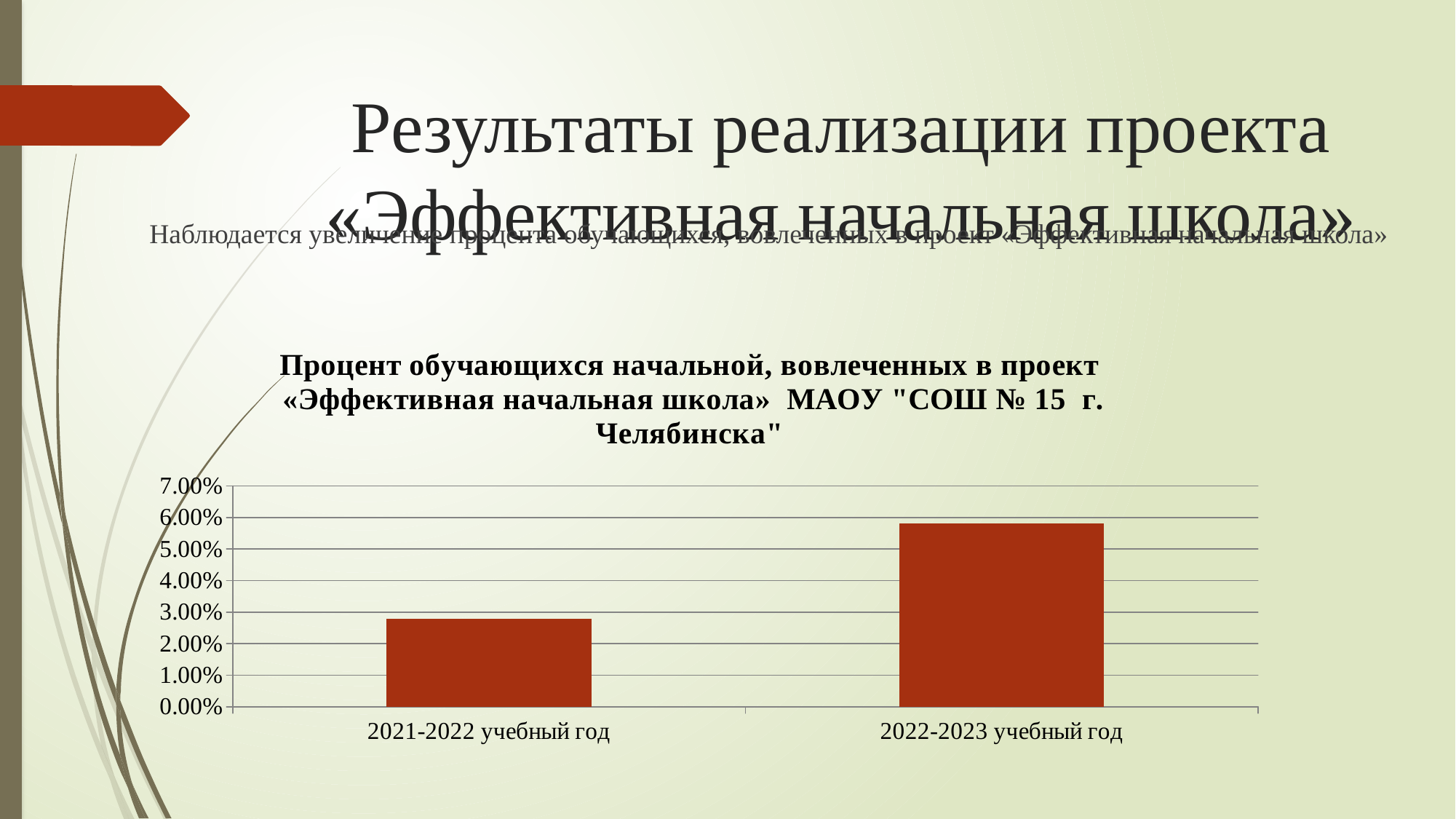
How many categories (school years) are plotted on the chart? 2 Which school year has the higher value on the chart? 2022-2023 учебный год What kind of chart is shown on the slide? bar chart Which school year has the lower value on the chart? 2021-2022 учебный год Is the value for 2022-2023 учебный год greater or less than 6.00%? less What is the highest value shown on the vertical axis of the chart? 7.00% Is the value for 2021-2022 учебный год greater or less than 3.00%? less What colour are the bars in the chart? red Is the value for 2021-2022 учебный год greater or less than 2.00%? greater Which is larger: the value for 2021-2022 учебный год or the value for 2022-2023 учебный год? 2022-2023 учебный год Do the values rise or fall from 2021-2022 to 2022-2023? rise